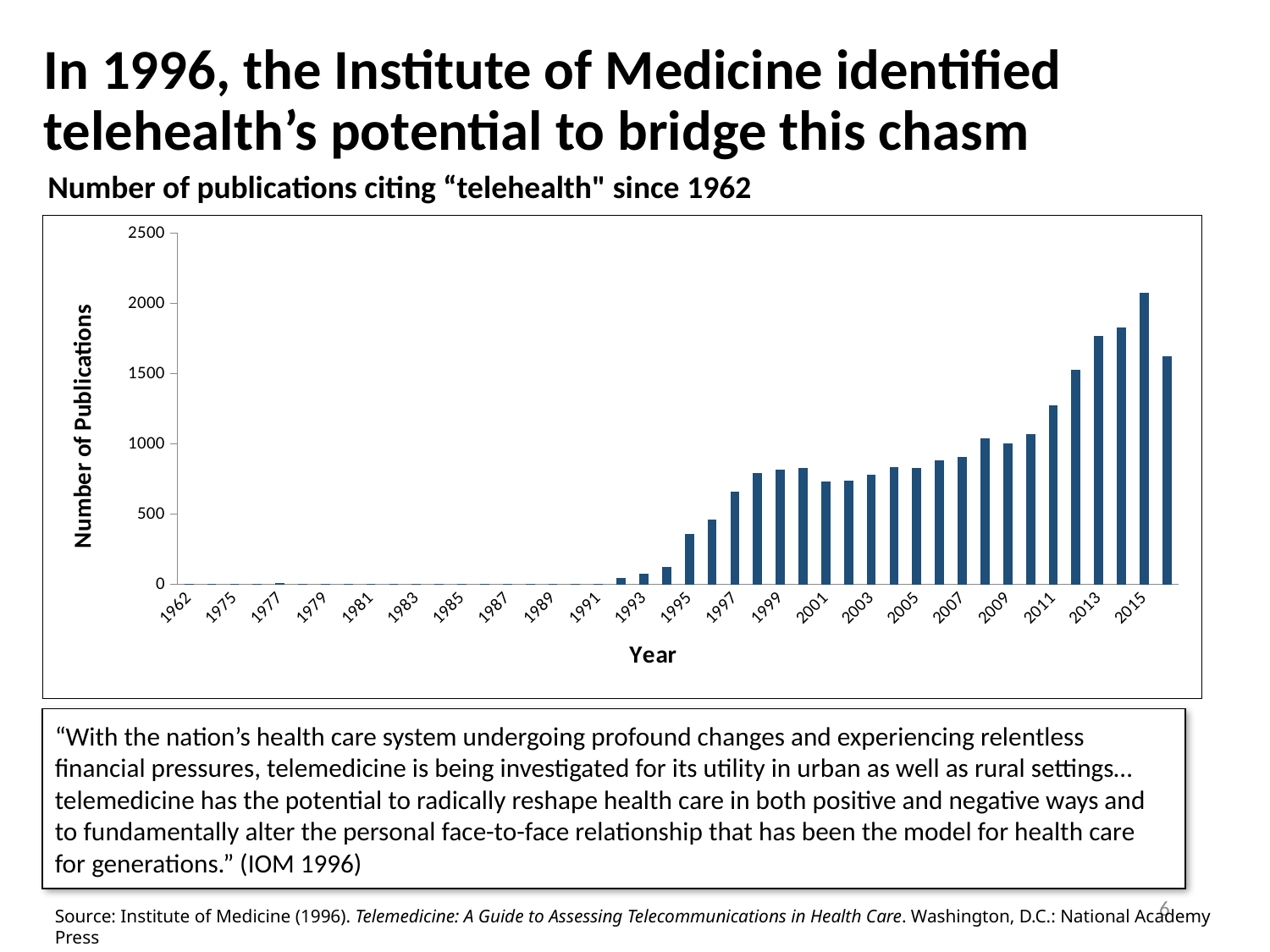
Is the value for 2011 greater or less than 1500? less Which year has the highest number of publications? 2015 Is the value for 2013 greater or less than 1500? greater What is the label on the vertical axis of the chart? Number of Publications What kind of chart is shown on the slide? bar chart Is the value for 2015 greater or less than 2000? greater Do the number of publications generally rise or fall from 1993 to 2015? rise Which year has the larger number of publications, 2011 or 2013? 2013 What is the title of the chart? Number of publications citing "telehealth" since 1962